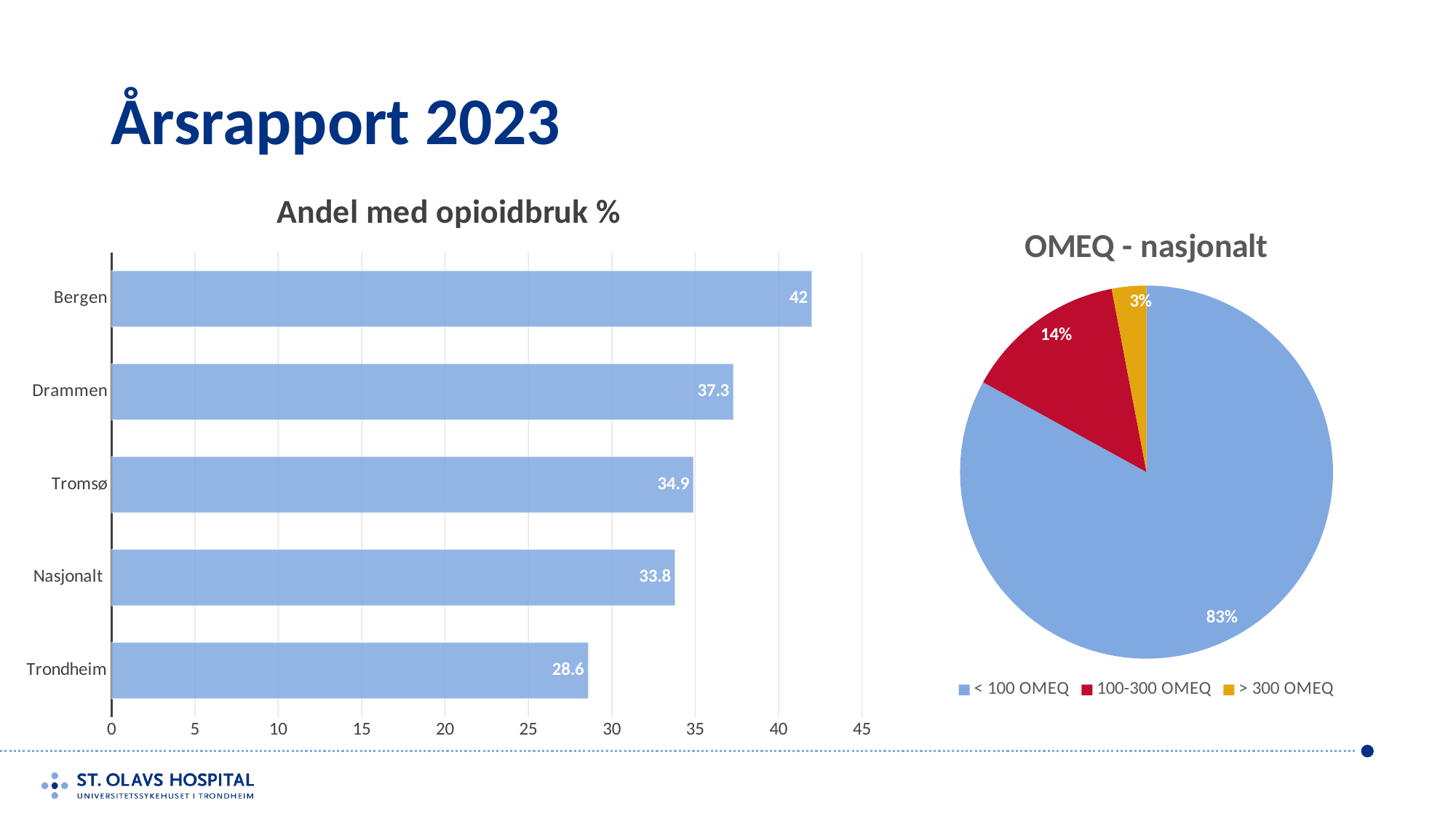
How many entries does the legend of the 'OMEQ - nasjonalt' pie chart list? 3 How many categories are shown in the 'Andel med opioidbruk %' chart? 5 In the 'Andel med opioidbruk %' chart, what is the value for Trondheim? 28.6 In the 'Andel med opioidbruk %' chart, which category has the highest value? Bergen In the 'OMEQ - nasjonalt' pie chart, what share does the '< 100 OMEQ' slice have? 83% In the 'Andel med opioidbruk %' chart, what is the difference between the values for Bergen and Trondheim? 13.4 In the 'Andel med opioidbruk %' chart, what is the value for Bergen? 42 In the 'Andel med opioidbruk %' chart, which category has the lowest value? Trondheim In the 'OMEQ - nasjonalt' pie chart, what share does the '100-300 OMEQ' slice have? 14% In the 'Andel med opioidbruk %' chart, which is larger, the value for Drammen or the value for Tromsø? Drammen In the 'Andel med opioidbruk %' chart, what is the value for Nasjonalt? 33.8 What kind of chart is 'Andel med opioidbruk %'? Bar chart